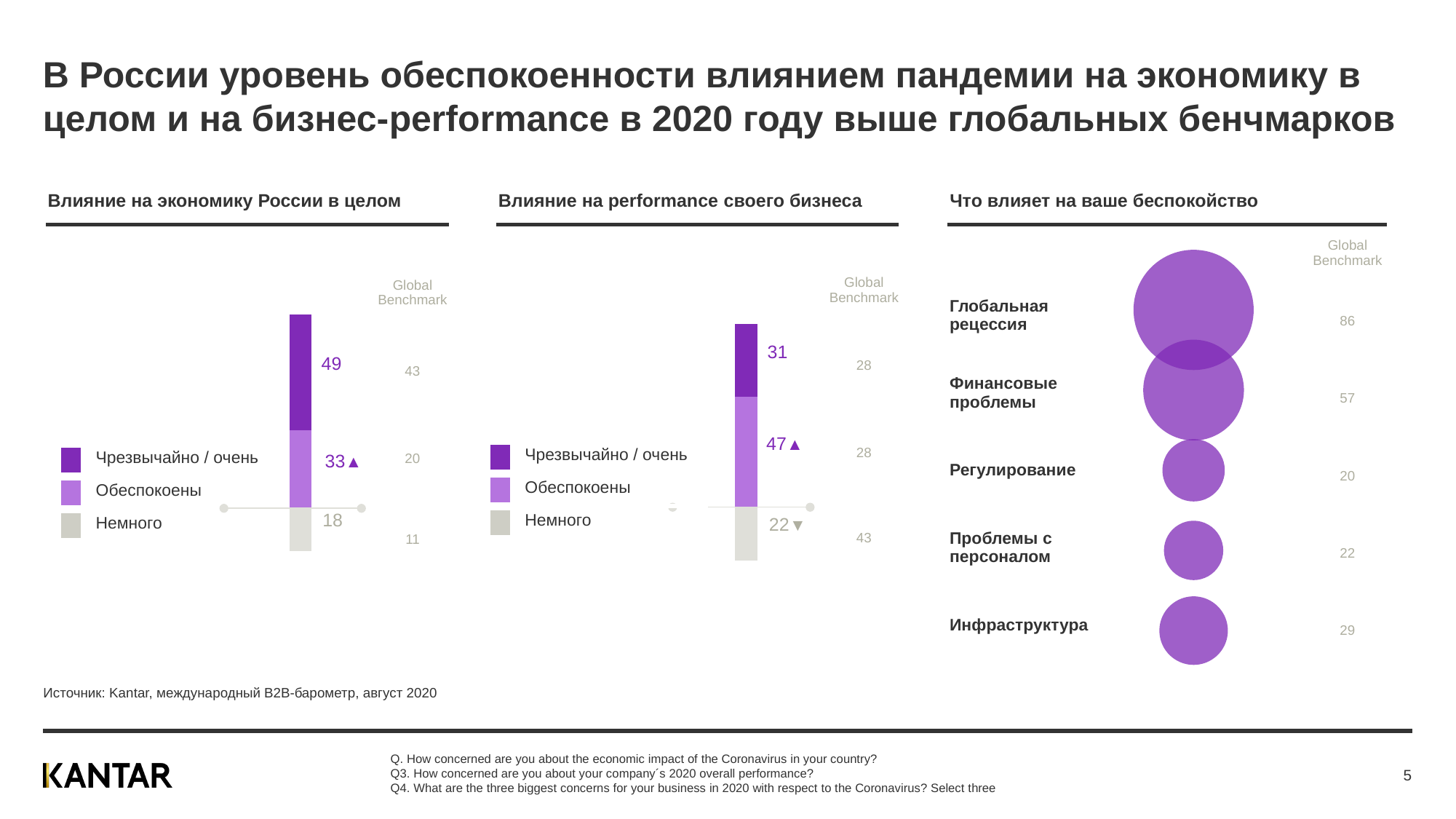
In the chart 'Влияние на performance своего бизнеса', what is the value for 'Обеспокоены'? 47 In the chart 'Влияние на performance своего бизнеса', which segment has the highest value? Обеспокоены In the chart 'Влияние на экономику России в целом', which segment has the lowest value? Немного In the chart 'Влияние на экономику России в целом', what is the value for 'Чрезвычайно / очень'? 49 In the chart 'Что влияет на ваше беспокойство', what is the Global Benchmark value for 'Финансовые проблемы'? 57 In the chart 'Что влияет на ваше беспокойство', how many categories are shown? 5 How many series does the legend list in the chart 'Влияние на экономику России в целом'? 3 In the chart 'Влияние на performance своего бизнеса', is the value for 'Чрезвычайно / очень' larger or smaller than its Global Benchmark? larger In the chart 'Влияние на экономику России в целом', what is the Global Benchmark value for 'Обеспокоены'? 20 What kind of chart is 'Влияние на performance своего бизнеса'? Stacked bar chart In the chart 'Влияние на performance своего бизнеса', what is the Global Benchmark value for 'Немного'? 43 In the chart 'Влияние на экономику России в целом', what is the difference between the Russian value for 'Чрезвычайно / очень' and its Global Benchmark? 6